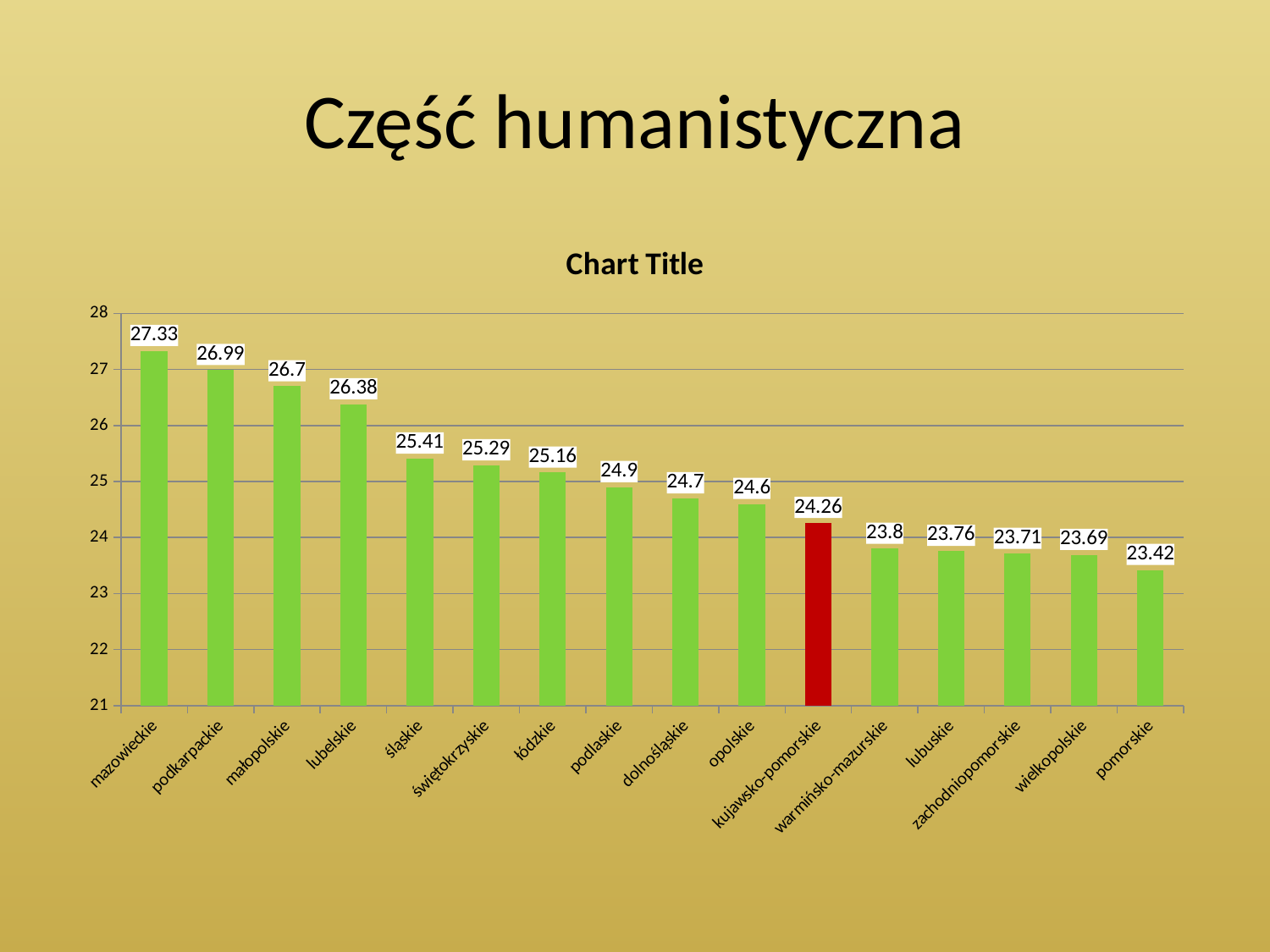
Is the value for opolskie greater or less than 24? greater Do the values rise or fall from left to right along the x axis? fall Which category has the lowest value? pomorskie Which category has the highest value? mazowieckie Which category's bar is coloured red instead of green? kujawsko-pomorskie Which is larger, the value for lubelskie or the value for śląskie? lubelskie What kind of chart is shown on the slide? bar chart How many categories are shown on the x axis? 16 What is the value for kujawsko-pomorskie? 24.26 What is the value for pomorskie? 23.42 What is the difference between the values for mazowieckie and pomorskie? 3.91 What is the value for mazowieckie? 27.33